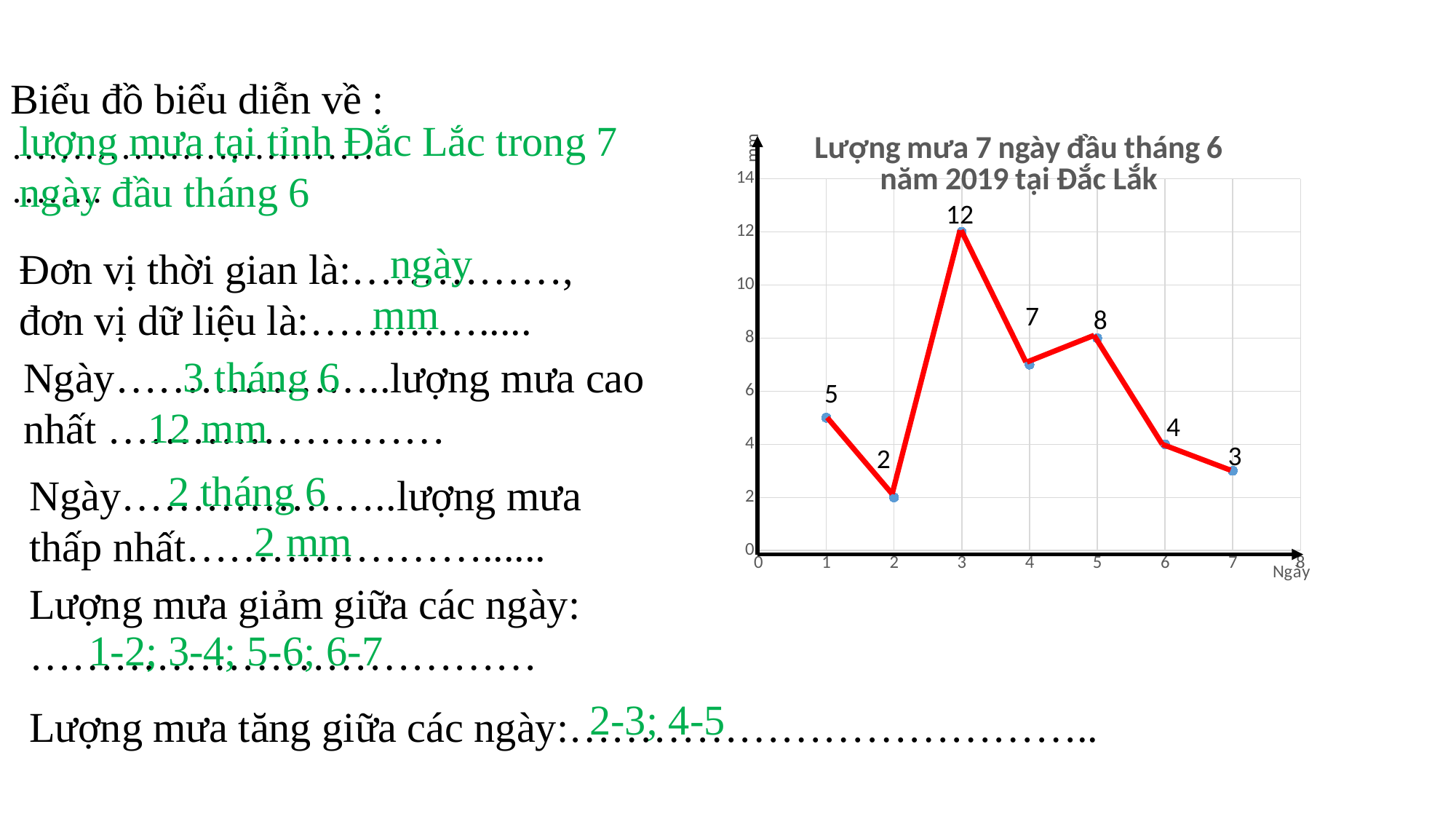
What is the rainfall value on day 5? 8 What is the difference between the rainfall on day 5 and on day 4? 1 Which day has more rainfall, day 1 or day 6? day 1 What is the difference between the rainfall on day 3 and on day 2? 10 What is the title of the chart? Lượng mưa 7 ngày đầu tháng 6 năm 2019 tại Đắc Lắk Does the rainfall rise or fall from day 5 to day 7? fall What is the rainfall value on day 7? 3 On which day is the rainfall lowest? 2 What is the rainfall value on day 3? 12 On which day is the rainfall highest? 3 What type of chart is shown on the slide? line chart How many data points are plotted on the chart? 7